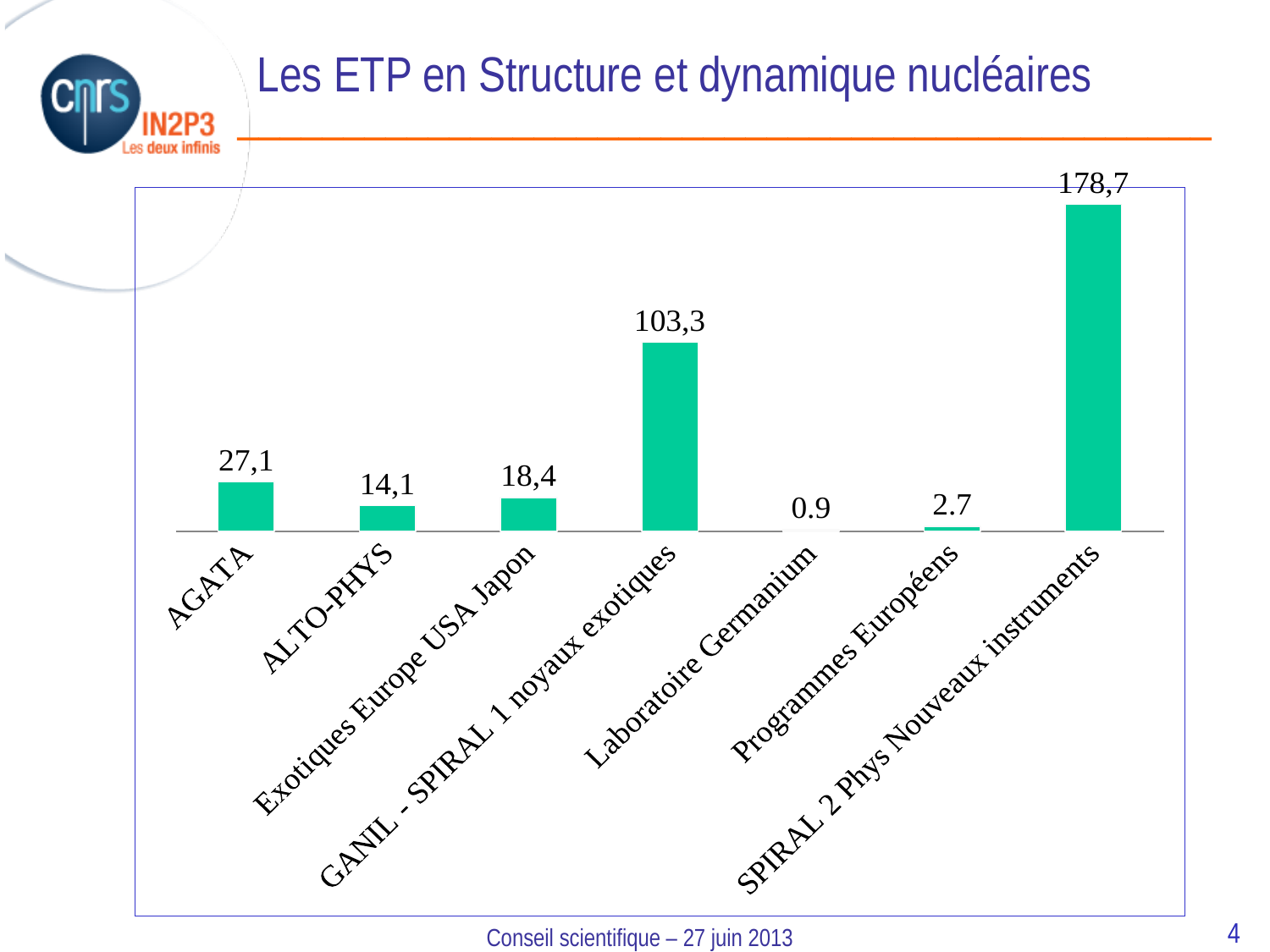
What is the value for Programmes Européens? 2.7 What is the value for Laboratoire Germanium? 0.9 What is the difference between the values for AGATA and ALTO-PHYS? 13 Which category has the lowest value? Laboratoire Germanium Which is larger, the value for Exotiques Europe USA Japon or the value for ALTO-PHYS? Exotiques Europe USA Japon What kind of chart is shown on the slide? Bar chart Which category has the highest value? SPIRAL 2 Phys Nouveaux instruments What is the value for AGATA? 27,1 What is the value for Exotiques Europe USA Japon? 18,4 What is the value for GANIL - SPIRAL 1 noyaux exotiques? 103,3 How many categories are shown in the chart? 7 What is the difference between the values for SPIRAL 2 Phys Nouveaux instruments and GANIL - SPIRAL 1 noyaux exotiques? 75,4